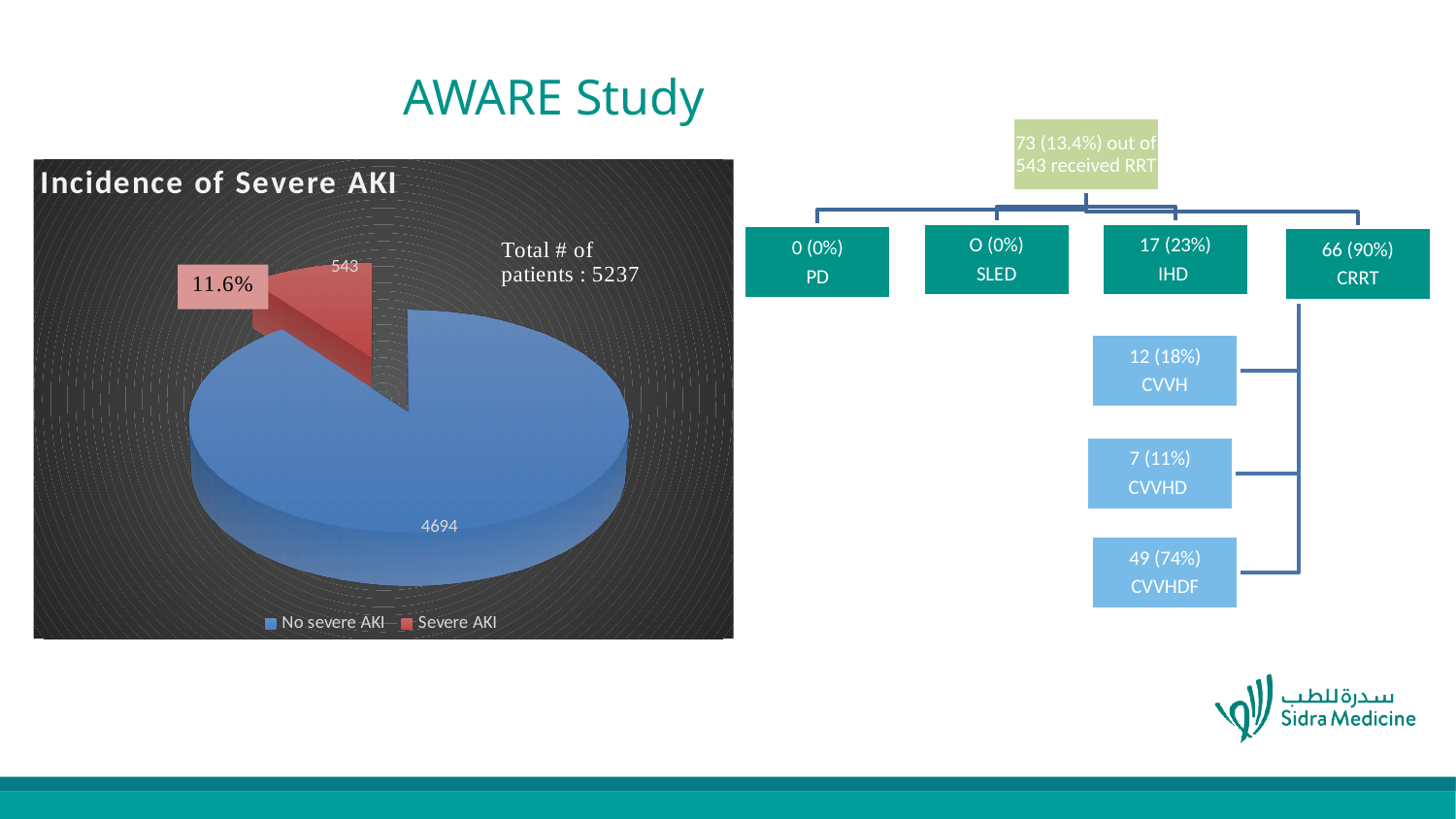
Which slice of the pie is the smallest? Severe AKI What kind of chart is shown on the slide? pie chart Which is larger, the No severe AKI slice or the Severe AKI slice? No severe AKI How many patients are in the Severe AKI slice? 543 What is the title of the chart? Incidence of Severe AKI What is the difference between the No severe AKI and Severe AKI counts? 4151 How many entries does the chart legend list? 2 How many patients are in the No severe AKI slice? 4694 Which slice of the pie is the largest? No severe AKI What total number of patients is stated on the chart? 5237 What percentage is printed next to the Severe AKI slice? 11.6% How many slices does the pie chart have? 2